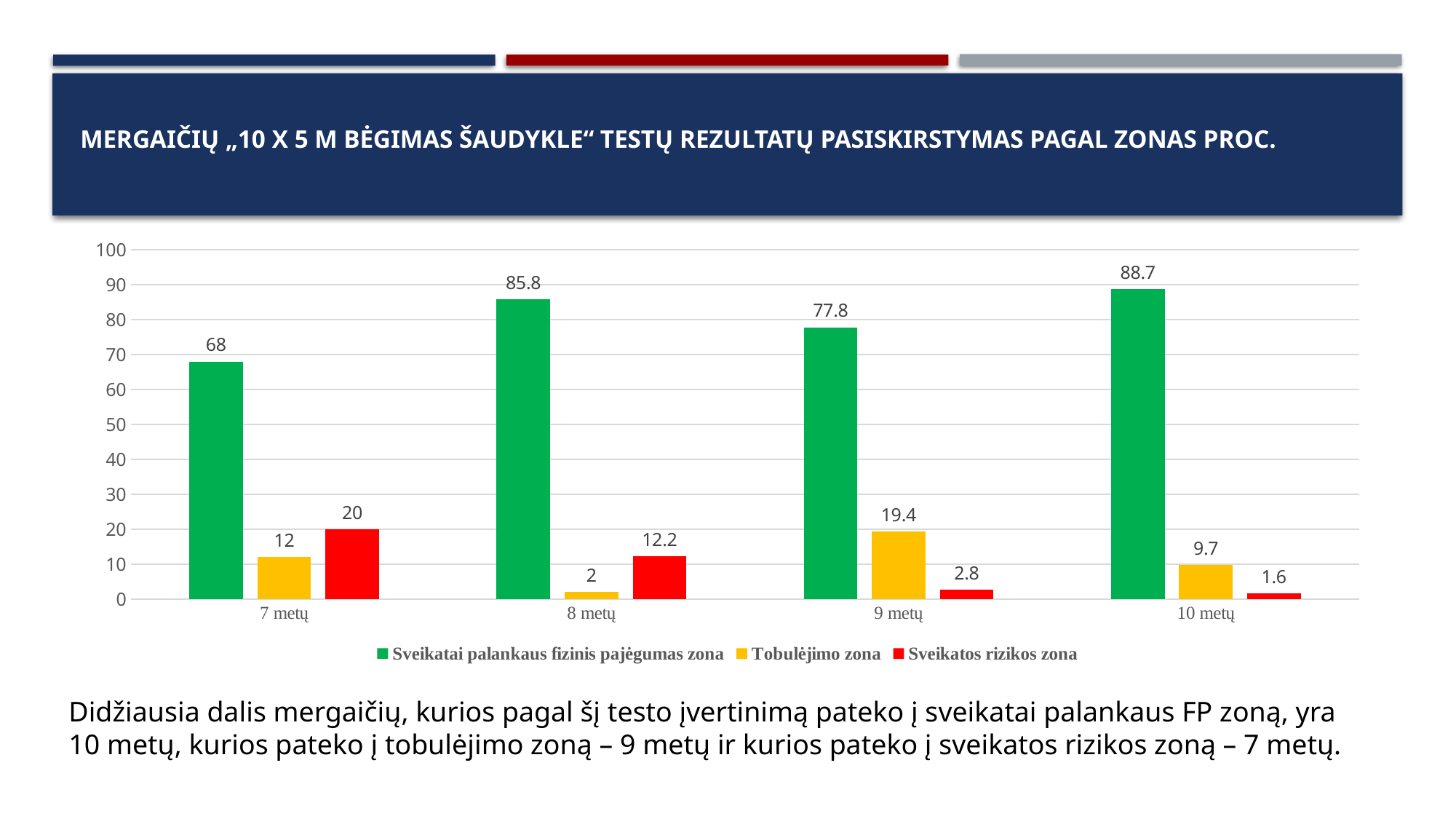
What is the value for 'Sveikatai palankaus fizinis pajėgumas zona' for 8 metų? 85.8 What is the value for 'Sveikatos rizikos zona' for 10 metų? 1.6 Is the value for 'Sveikatai palankaus fizinis pajėgumas zona' for 9 metų greater or less than 80? less What is the value for 'Tobulėjimo zona' for 9 metų? 19.4 Which is larger: the 'Tobulėjimo zona' value for 7 metų or for 10 metų? 7 metų What colour represents 'Sveikatos rizikos zona' in the chart? red How many age groups are shown on the x axis? 4 Which age group has the lowest value for 'Tobulėjimo zona'? 8 metų What is the difference between the 'Sveikatos rizikos zona' values for 7 metų and 8 metų? 7.8 Which age group has the highest value for 'Sveikatai palankaus fizinis pajėgumas zona'? 10 metų How many series does the legend list? 3 What kind of chart is shown on the slide? bar chart